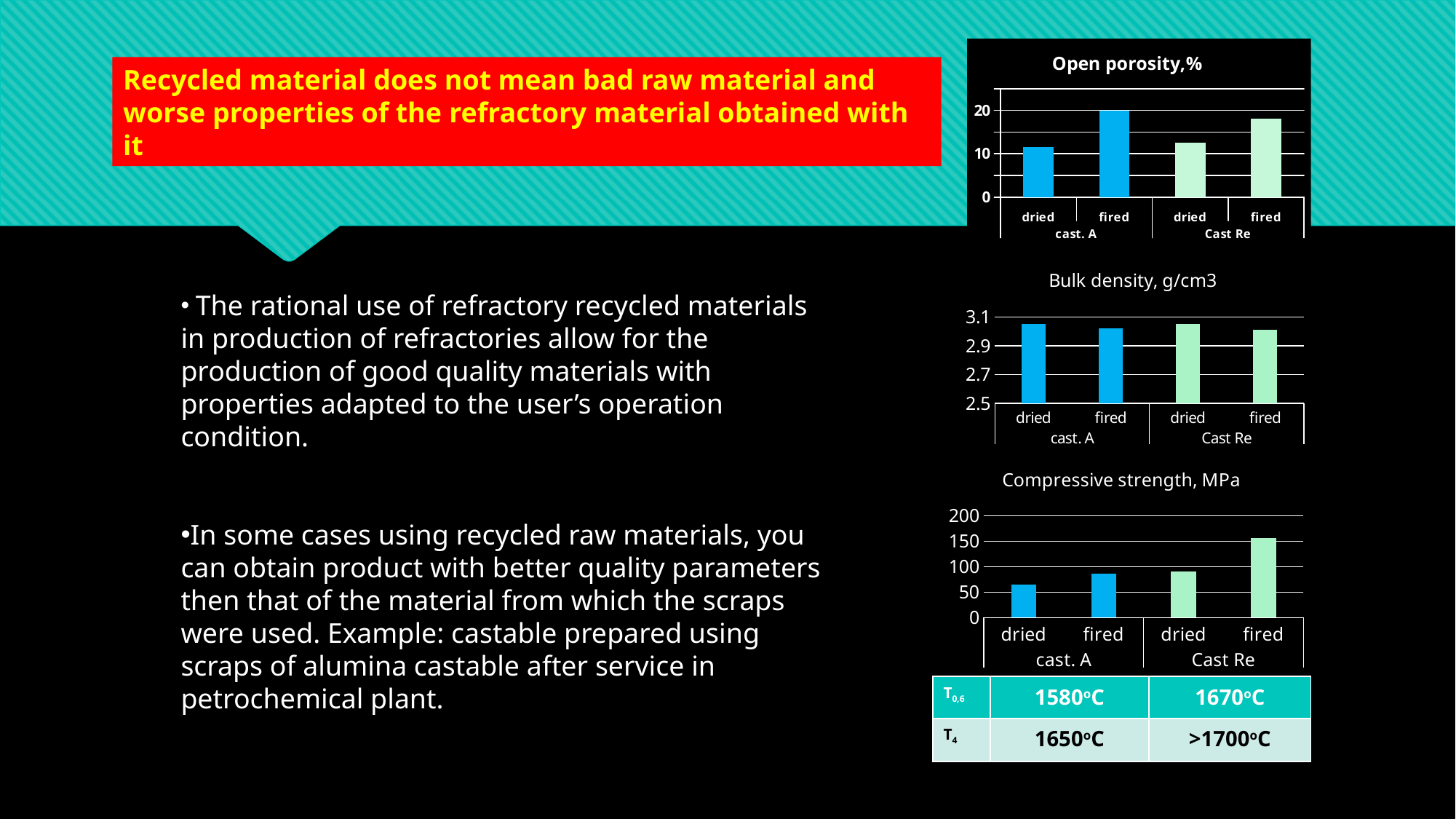
In the 'Open porosity,%' chart, which bar is the highest? fired, cast. A What kind of chart is the 'Open porosity,%' chart? bar chart In the 'Compressive strength, MPa' chart, which bar is the highest? fired, Cast Re In the 'Bulk density, g/cm3' chart, is the value for dried cast. A greater or less than 2.9? greater In the 'Compressive strength, MPa' chart, which bar is the lowest? dried, cast. A How many bars are plotted in the 'Bulk density, g/cm3' chart? 4 How many bars are plotted in the 'Open porosity,%' chart? 4 In the 'Open porosity,%' chart, which is larger: fired cast. A or fired Cast Re? fired cast. A In the 'Compressive strength, MPa' chart, which is larger: fired cast. A or fired Cast Re? fired Cast Re What is the title of the bottom chart on the slide? Compressive strength, MPa In the 'Open porosity,%' chart, is the value for fired cast. A greater or less than 10? greater In the 'Compressive strength, MPa' chart, is the value for fired Cast Re greater or less than 100? greater